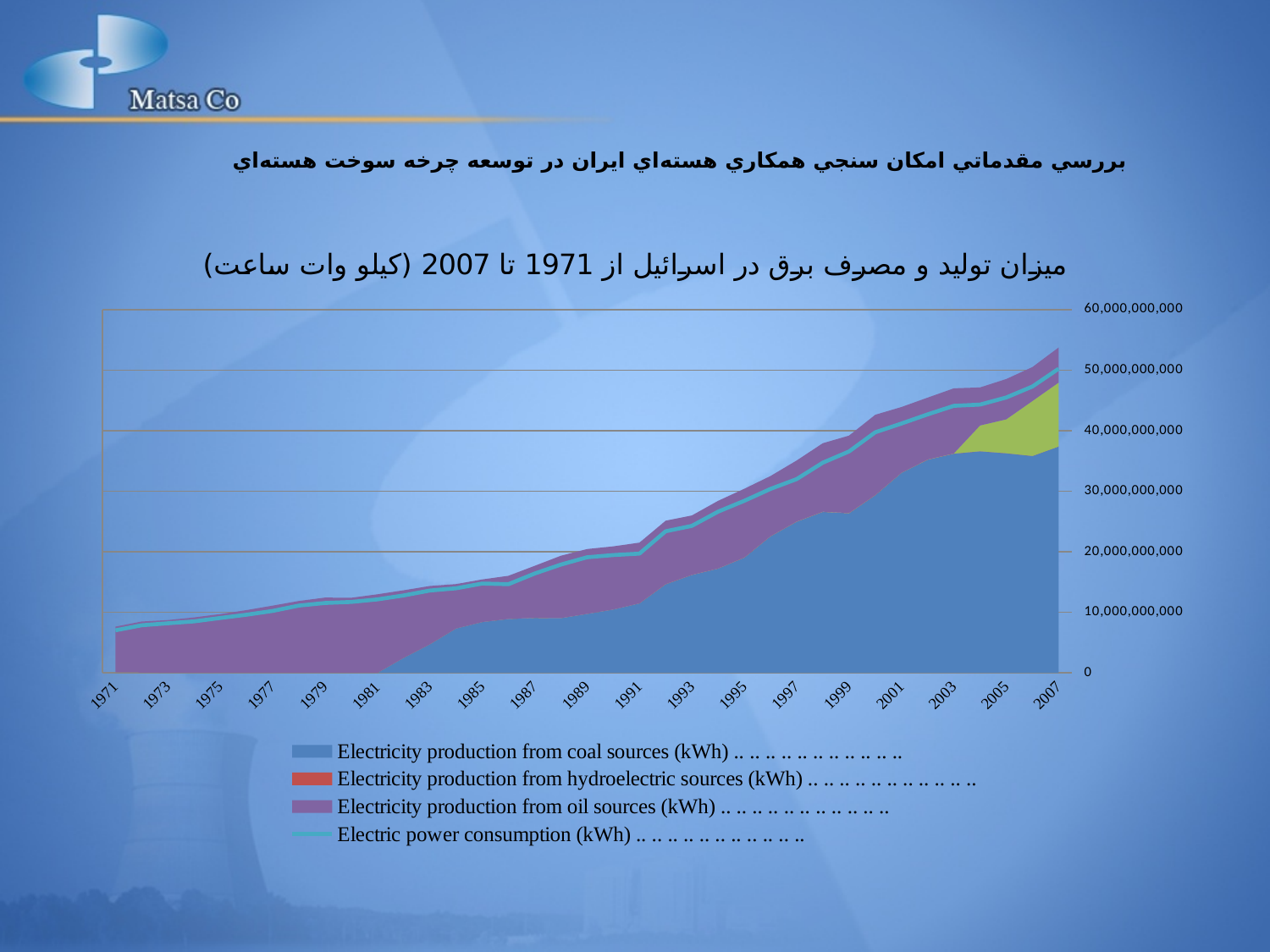
Is the value for electric power consumption in 1971 greater or less than 10,000,000,000? less Does electric power consumption rise or fall from 1971 to 2007? Rise Is the value for electric power consumption in 2001 greater or less than 40,000,000,000? greater How many year labels are shown on the x axis? 19 How many series does the legend list? 4 Which year has the highest electric power consumption? 2007 What colour represents electricity production from oil sources in the legend? Purple What kind of chart is shown on the slide? Area chart Is the value for electric power consumption in 1995 greater or less than 30,000,000,000? less Which is larger: electricity production from coal sources in 2007 or in 1991? 2007